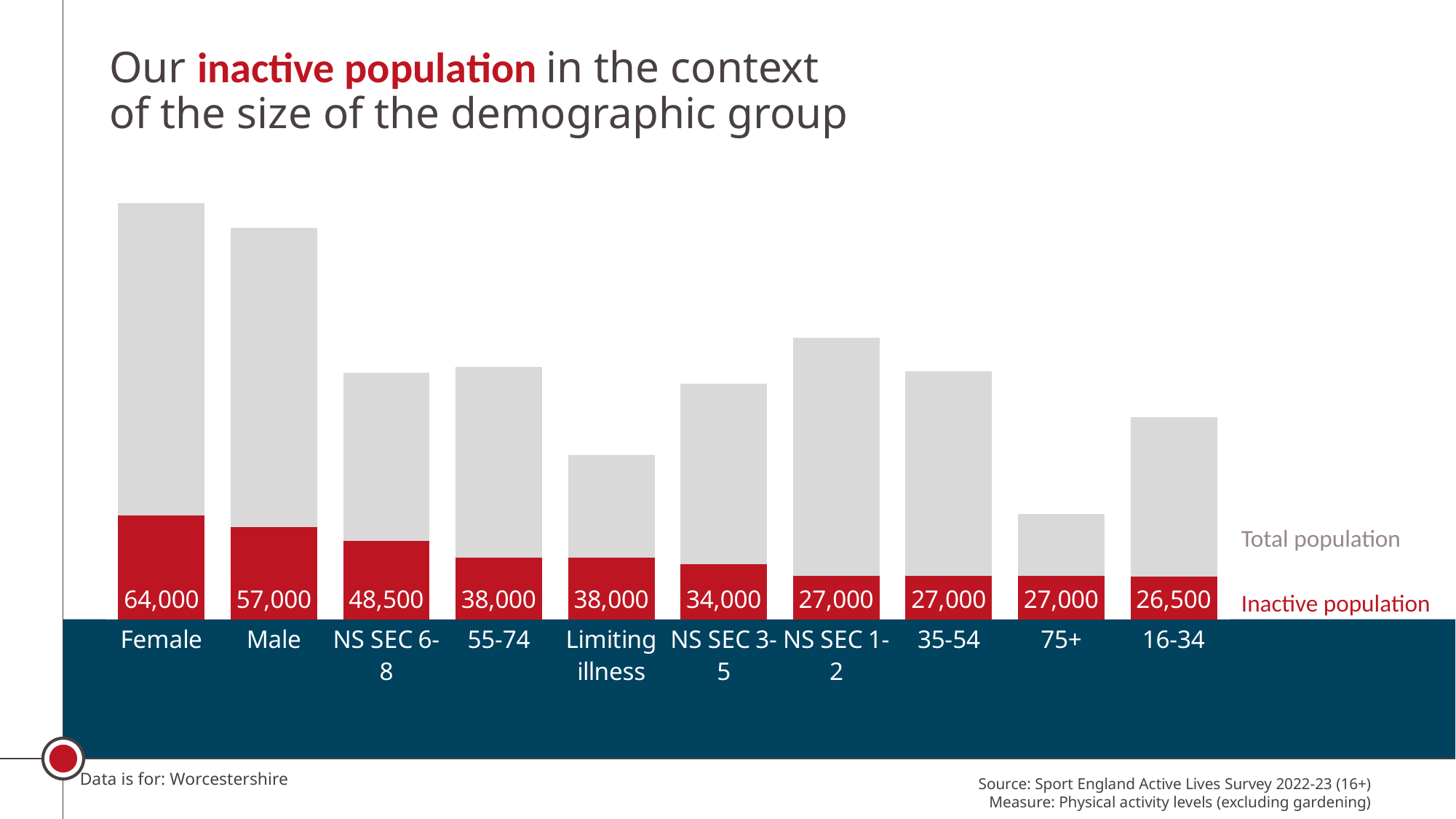
What is the inactive population for the 16-34 age group? 26,500 Which has the larger inactive population, Male or NS SEC 6-8? Male What is the difference between the inactive population of the Female group and the Male group? 7,000 How many demographic groups are shown on the chart? 10 What is the inactive population for the Female group? 64,000 What is the inactive population for the Limiting illness group? 38,000 Which group has the larger total population bar, Male or 16-34? Male Which demographic group has the smallest total population bar? 75+ Which demographic group has the lowest inactive population? 16-34 Which demographic group has the highest inactive population? Female How many series does the chart's legend list? 2 Do the inactive population values rise or fall from left to right across the chart? fall